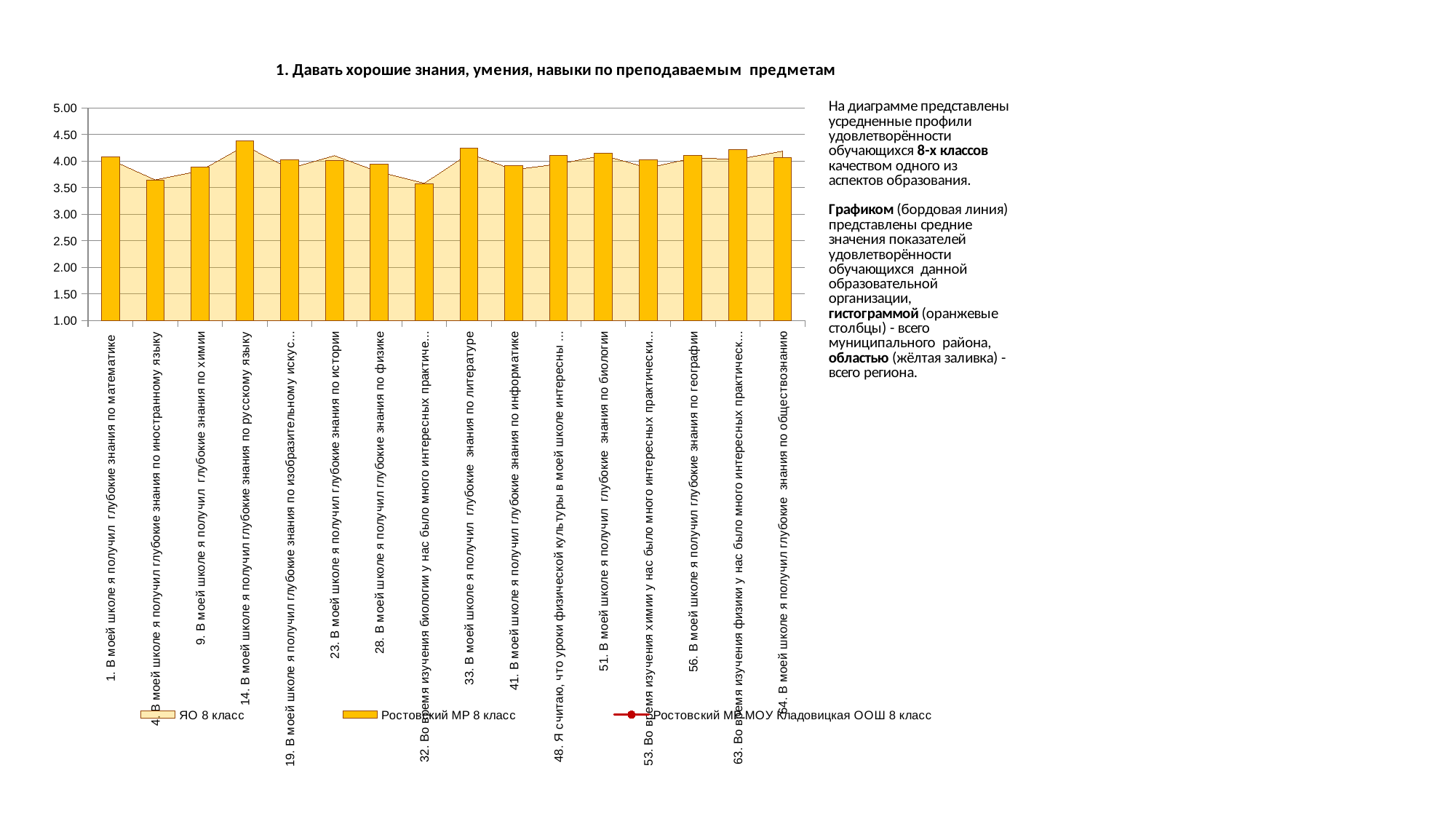
What is the title of the chart? 1. Давать хорошие знания, умения, навыки по преподаваемым предметам Which category has the lowest orange bar (Ростовский МР 8 класс)? 32. Во время изучения биологии у нас было много интересных практиче… How many series does the chart legend list? 3 How many categories are plotted along the x axis of the chart? 16 Is the Ростовский МР 8 класс value for "33. В моей школе я получил глубокие знания по литературе" greater or less than 4.00? greater What is the highest value shown on the chart's y axis? 5.00 Is the Ростовский МР 8 класс value for "4. В моей школе я получил глубокие знания по иностранному языку" greater or less than 4.00? less Is the Ростовский МР 8 класс value for "14. В моей школе я получил глубокие знания по русскому языку" greater or less than 4.00? greater Which category has the highest orange bar (Ростовский МР 8 класс)? 14. В моей школе я получил глубокие знания по русскому языку Which has the larger Ростовский МР 8 класс value: "14. В моей школе я получил глубокие знания по русскому языку" or "32. Во время изучения биологии у нас было много интересных практиче…"? 14. В моей школе я получил глубокие знания по русскому языку What kind of chart is shown on the slide? combination bar and area chart